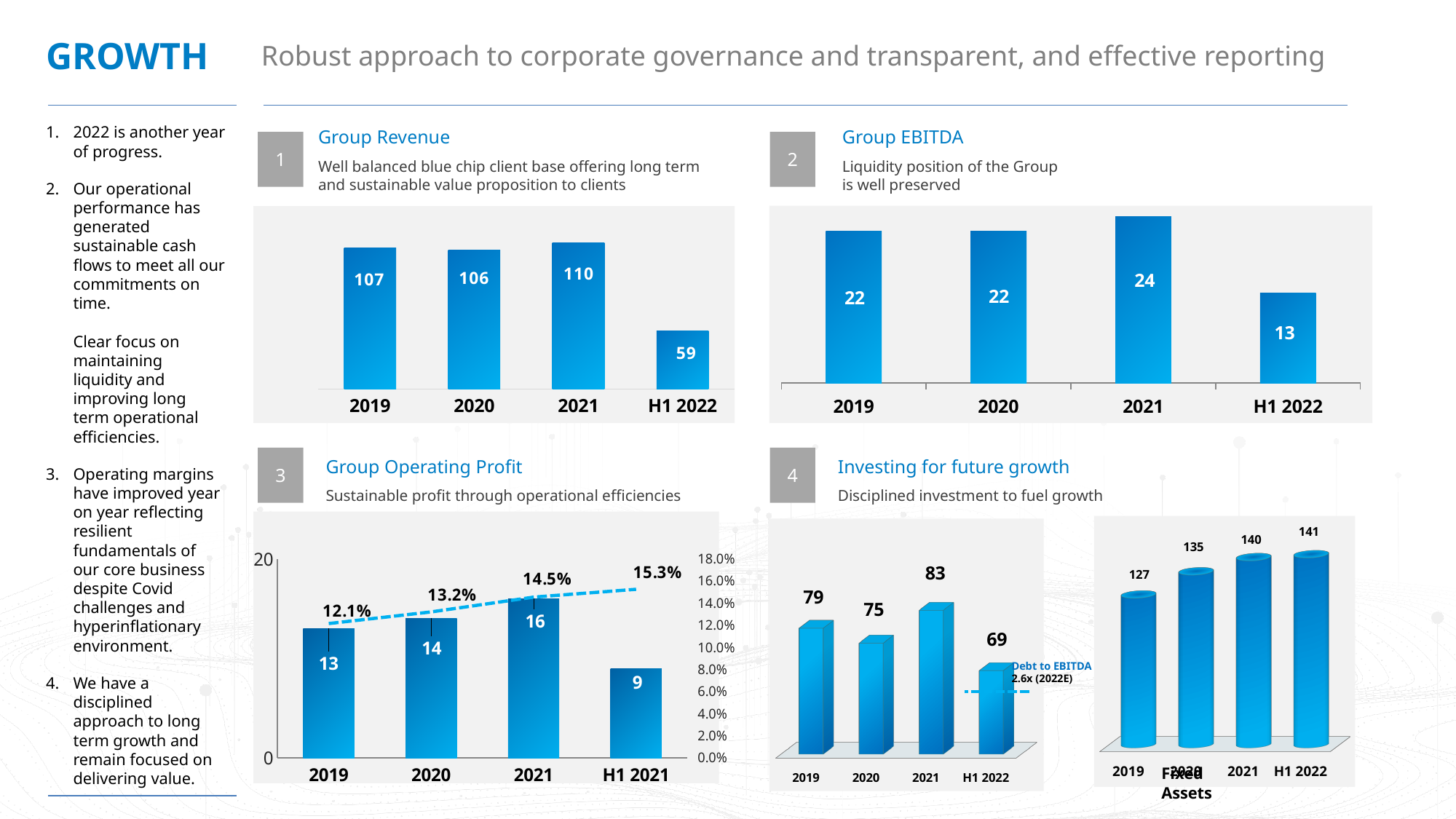
In the Group Operating Profit chart, what is the bar value for 2020? 14 In the Fixed Assets chart, what is the difference between the H1 2022 and 2019 values? 14 In the Group Revenue chart, what is the value for 2021? 110 In the Group Revenue chart, which year has the lowest value? H1 2022 In the Group Operating Profit chart, what is the margin percentage shown for 2021? 14.5% In the Group EBITDA chart, how many categories are shown on the x axis? 4 In the Group Operating Profit chart, do the margin percentages rise or fall from 2019 to H1 2021? rise In the left chart under Investing for future growth, what is the value for 2021? 83 In the Group Revenue chart, what is the difference between the 2019 and 2020 values? 1 In the Fixed Assets chart, what is the value for 2019? 127 In the Group EBITDA chart, which year has the highest value? 2021 In the Group EBITDA chart, what is the value for 2021? 24